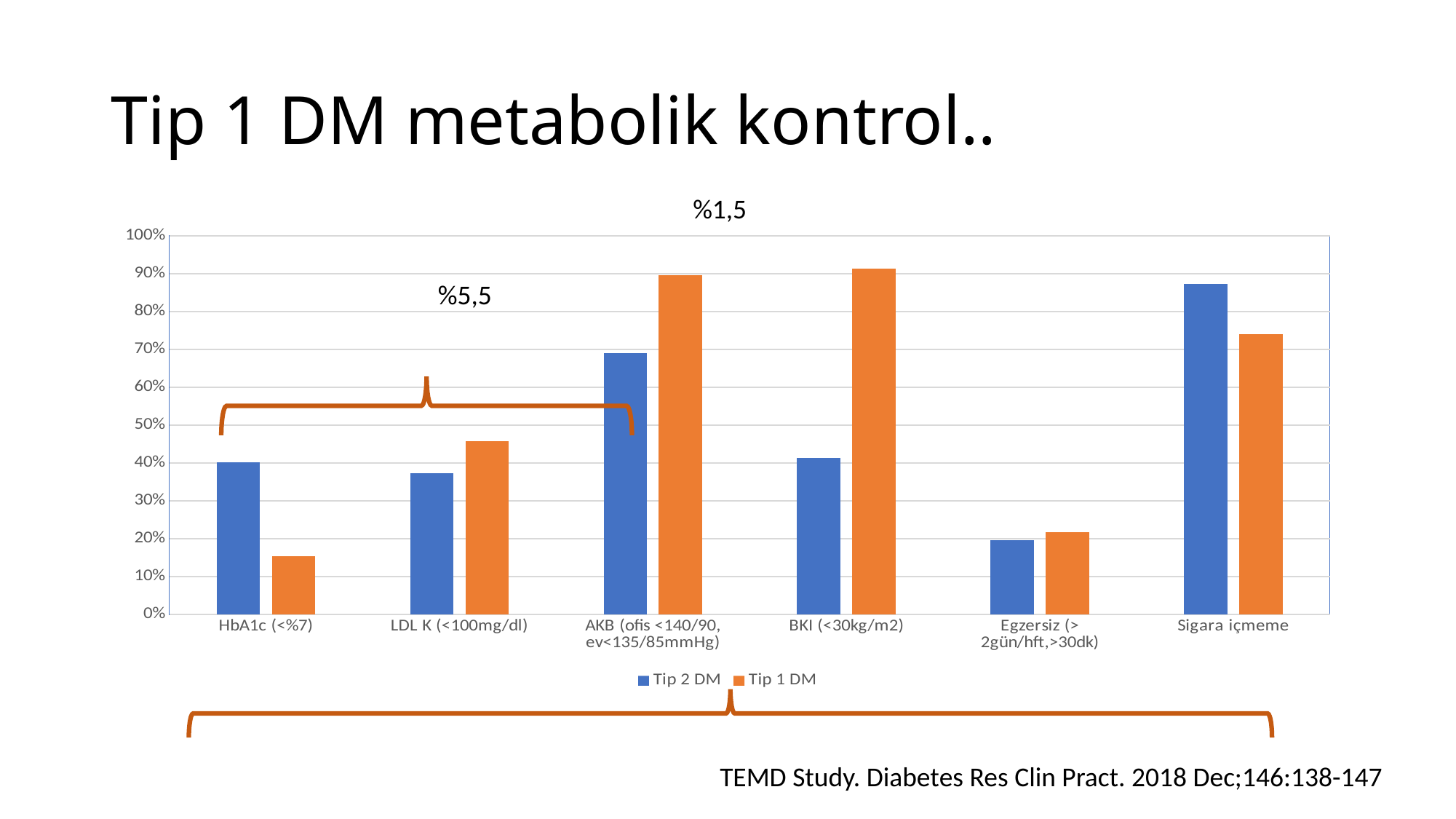
For which category is the Tip 1 DM value lowest? HbA1c (<%7) How many categories are shown on the x axis of the chart? 6 What kind of chart is shown on the slide? bar chart Is the Tip 1 DM value for BKI (<30kg/m2) greater or less than 80%? greater For which category is the Tip 2 DM value lowest? Egzersiz (> 2gün/hft,>30dk) For HbA1c (<%7), which series has the larger value, Tip 2 DM or Tip 1 DM? Tip 2 DM How many series does the chart's legend list? 2 For which category is the Tip 2 DM value highest? Sigara içmeme Is the Tip 1 DM value for HbA1c (<%7) greater or less than 20%? less For BKI (<30kg/m2), which series has the larger value, Tip 2 DM or Tip 1 DM? Tip 1 DM Is the Tip 2 DM value for AKB (ofis <140/90, ev<135/85mmHg) greater or less than 60%? greater Which series does the orange bar represent? Tip 1 DM